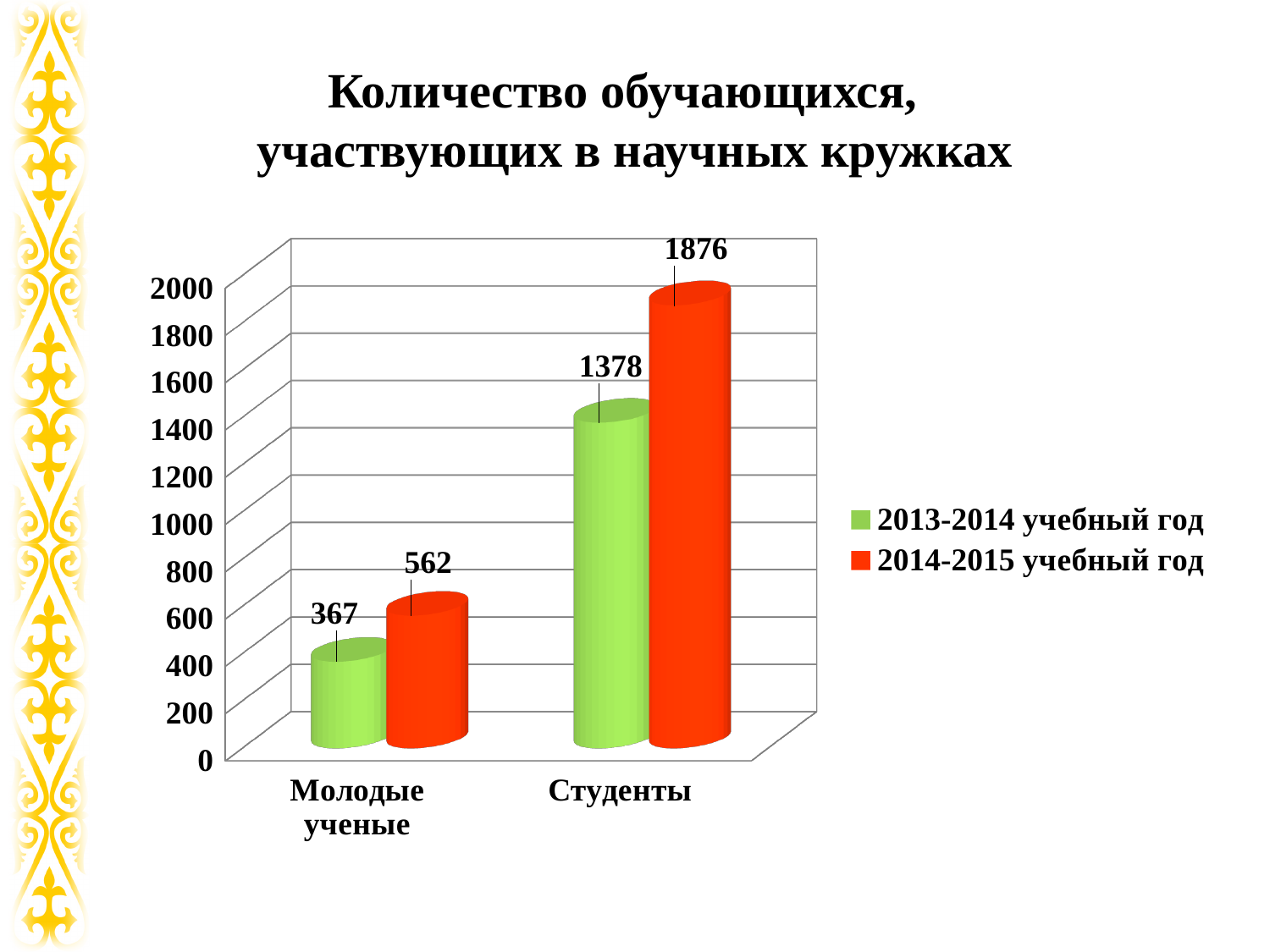
What is the value for Студенты in the 2013-2014 учебный год series? 1378 Which is larger for Студенты: the 2013-2014 учебный год value or the 2014-2015 учебный год value? 2014-2015 учебный год What is the difference between the 2014-2015 and 2013-2014 values for Молодые ученые? 195 How many categories are shown on the x axis? 2 What is the difference between the 2014-2015 and 2013-2014 values for Студенты? 498 What is the value for Молодые ученые in the 2013-2014 учебный год series? 367 How many series does the legend list? 2 What is the value for Студенты in the 2014-2015 учебный год series? 1876 Which category has the highest value in the 2014-2015 учебный год series? Студенты What kind of chart is shown on the slide? Bar chart Which category has the lowest value in the 2013-2014 учебный год series? Молодые ученые What is the value for Молодые ученые in the 2014-2015 учебный год series? 562